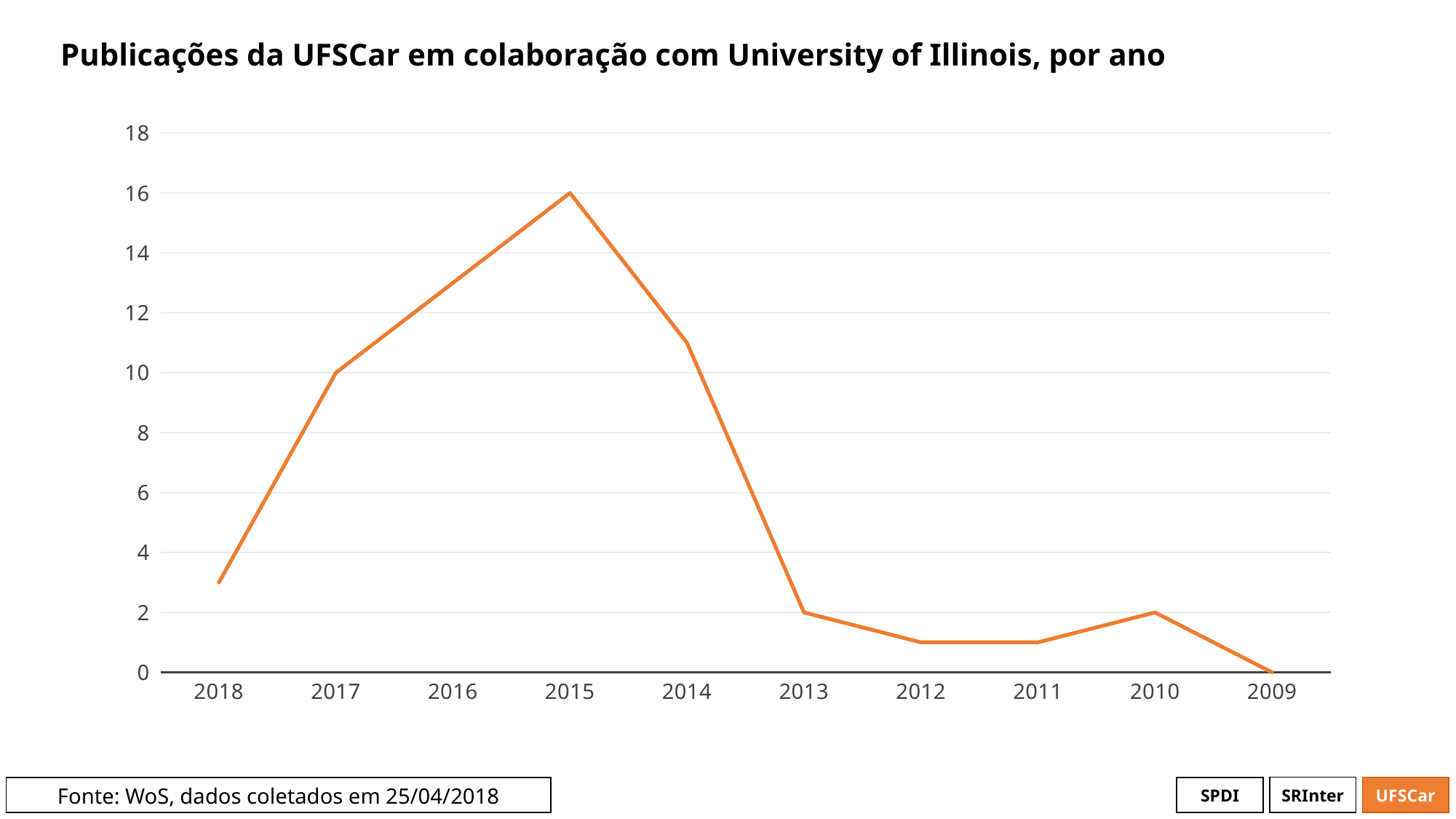
What is the value for 2015? 16 Which year has the lowest number of publications? 2009 What kind of chart is shown on the slide? line chart What is the difference between the values for 2015 and 2017? 6 Which year has the highest number of publications? 2015 What is the title of the chart? Publicações da UFSCar em colaboração com University of Illinois, por ano What is the value for 2009? 0 What is the value for 2017? 10 Which is larger, the value for 2017 or the value for 2013? 2017 Is the value for 2016 greater or less than 12? greater Is the value for 2018 greater or less than 4? less How many years are plotted on the x axis? 10